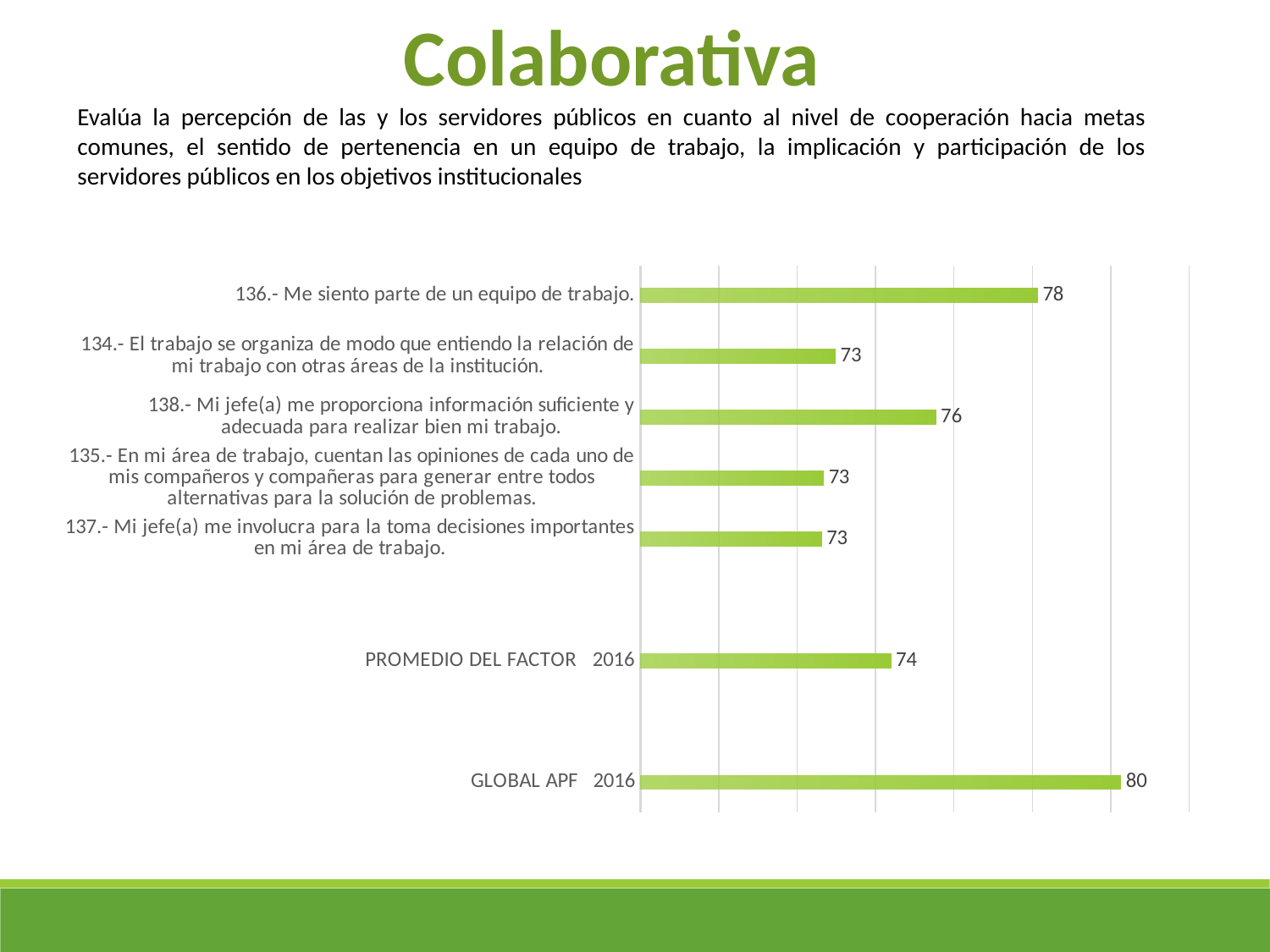
What is the value for item 136 ("Me siento parte de un equipo de trabajo")? 78 What is the value for item 138 ("Mi jefe(a) me proporciona información suficiente y adecuada para realizar bien mi trabajo")? 76 What is the difference between the value for GLOBAL APF 2016 and PROMEDIO DEL FACTOR 2016? 6 Which category has the highest value in the chart? GLOBAL APF 2016 What is the difference between the value for item 136 and item 137? 5 What kind of chart is shown on the slide? Bar chart How many bars are plotted in the chart? 7 Among the numbered survey items (134 to 138), which has the highest value? 136.- Me siento parte de un equipo de trabajo. What is the value for item 134 ("El trabajo se organiza de modo que entiendo la relación de mi trabajo con otras áreas de la institución")? 73 What is the value for PROMEDIO DEL FACTOR 2016? 74 What is the value for GLOBAL APF 2016? 80 Which is larger: the value for item 138 or the value for PROMEDIO DEL FACTOR 2016? Item 138